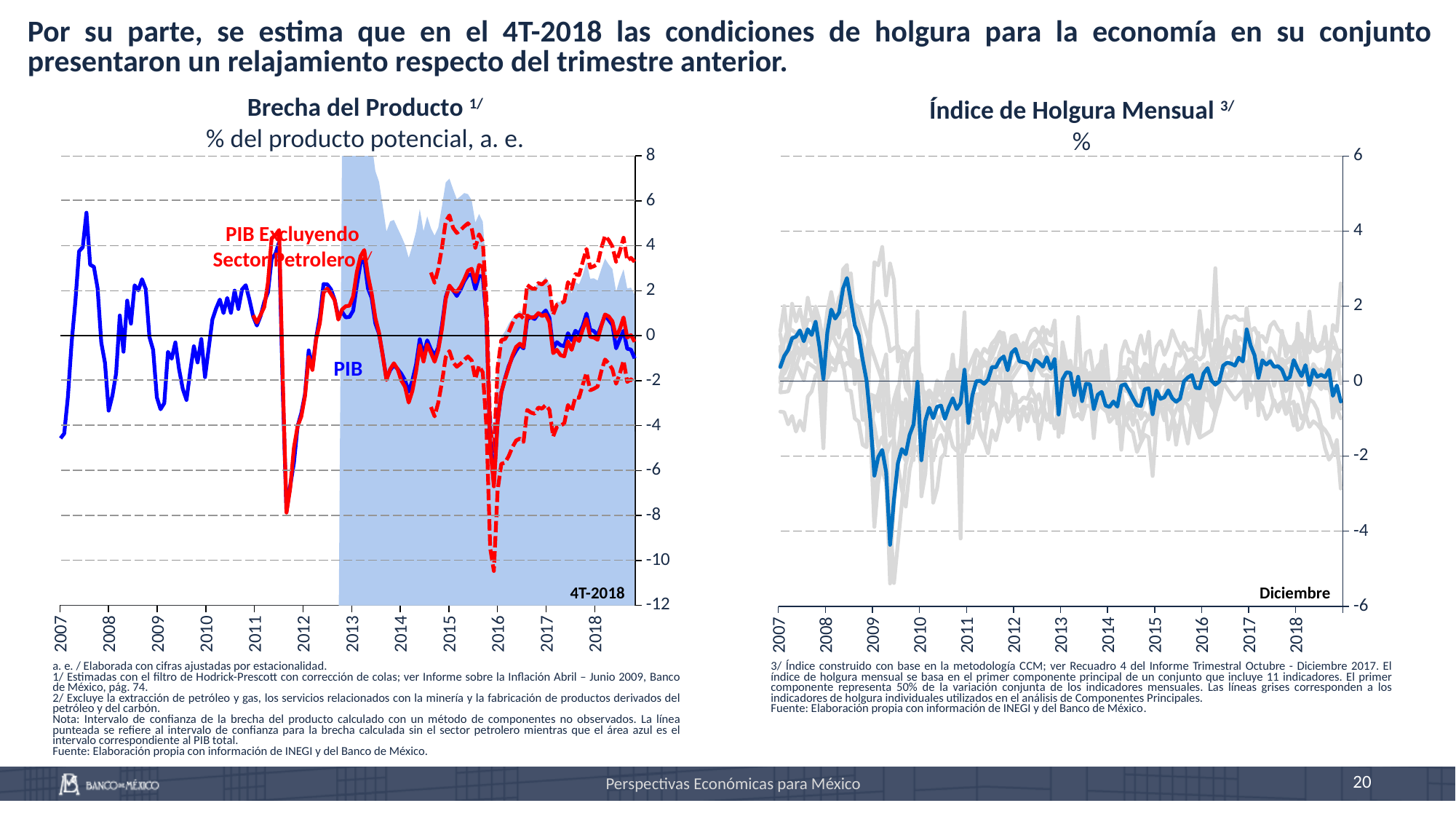
In the 'Brecha del Producto' chart, does the PIB line rise or fall from its 2009 trough to 2011? rise What kind of chart is the 'Índice de Holgura Mensual' chart on the right? Line chart In the 'Índice de Holgura Mensual' chart, is the peak of the blue line in 2008 greater or less than 2? greater In the 'Índice de Holgura Mensual' chart, is the lowest value of the blue line in 2009 greater or less than -2? less In the 'Brecha del Producto' chart, is the peak of the PIB line in 2007 greater or less than 4? greater In the 'Brecha del Producto' chart, what is the label shown at the end of the series, marking the last period? 4T-2018 In the 'Índice de Holgura Mensual' chart, what is the label shown at the end of the series, marking the last month? Diciembre In the 'Índice de Holgura Mensual' chart, does the blue line rise or fall from its 2017 peak to the end of 2018? fall In the 'Brecha del Producto' chart, which year on the x axis is the first and which is the last? 2007 and 2018 What kind of chart is the 'Brecha del Producto' chart on the left? Line chart